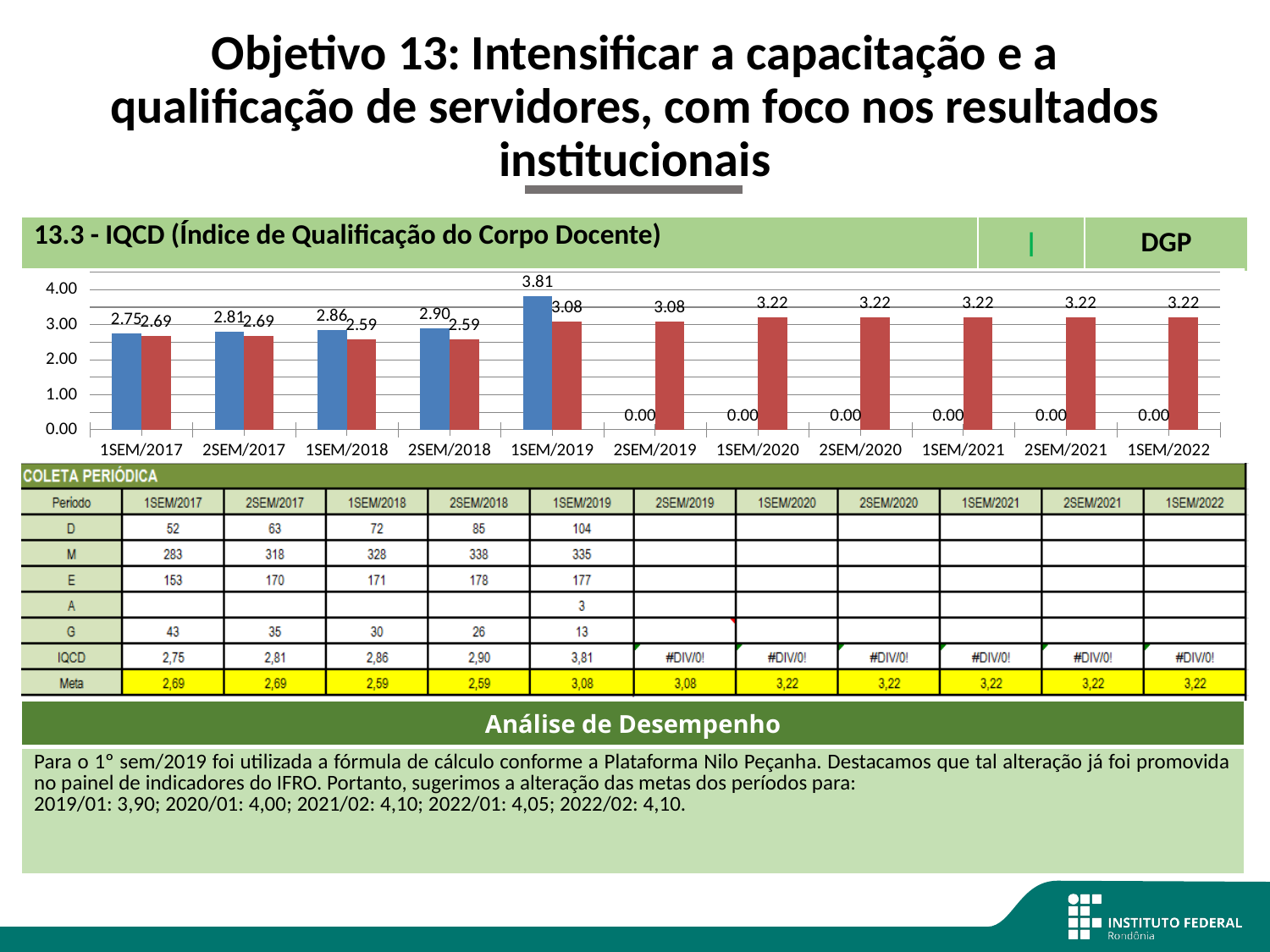
What is the value of the red bar for 1SEM/2022? 3.22 What is the lowest value shown for the red bars? 2.59 Is the value of the blue bar for 1SEM/2019 greater or less than 3.00? greater For 1SEM/2017, which is larger, the blue bar or the red bar? the blue bar Do the blue bars rise or fall from 1SEM/2017 to 1SEM/2019? rise What is the difference between the blue bar and the red bar for 2SEM/2018? 0.31 What is the value of the blue bar for 2SEM/2019? 0.00 What is the difference between the blue bar and the red bar for 1SEM/2019? 0.73 Which period has the highest blue bar? 1SEM/2019 What is the value of the blue bar for 1SEM/2019? 3.81 How many periods are shown on the x axis of the chart? 11 What kind of chart is shown on the slide? bar chart